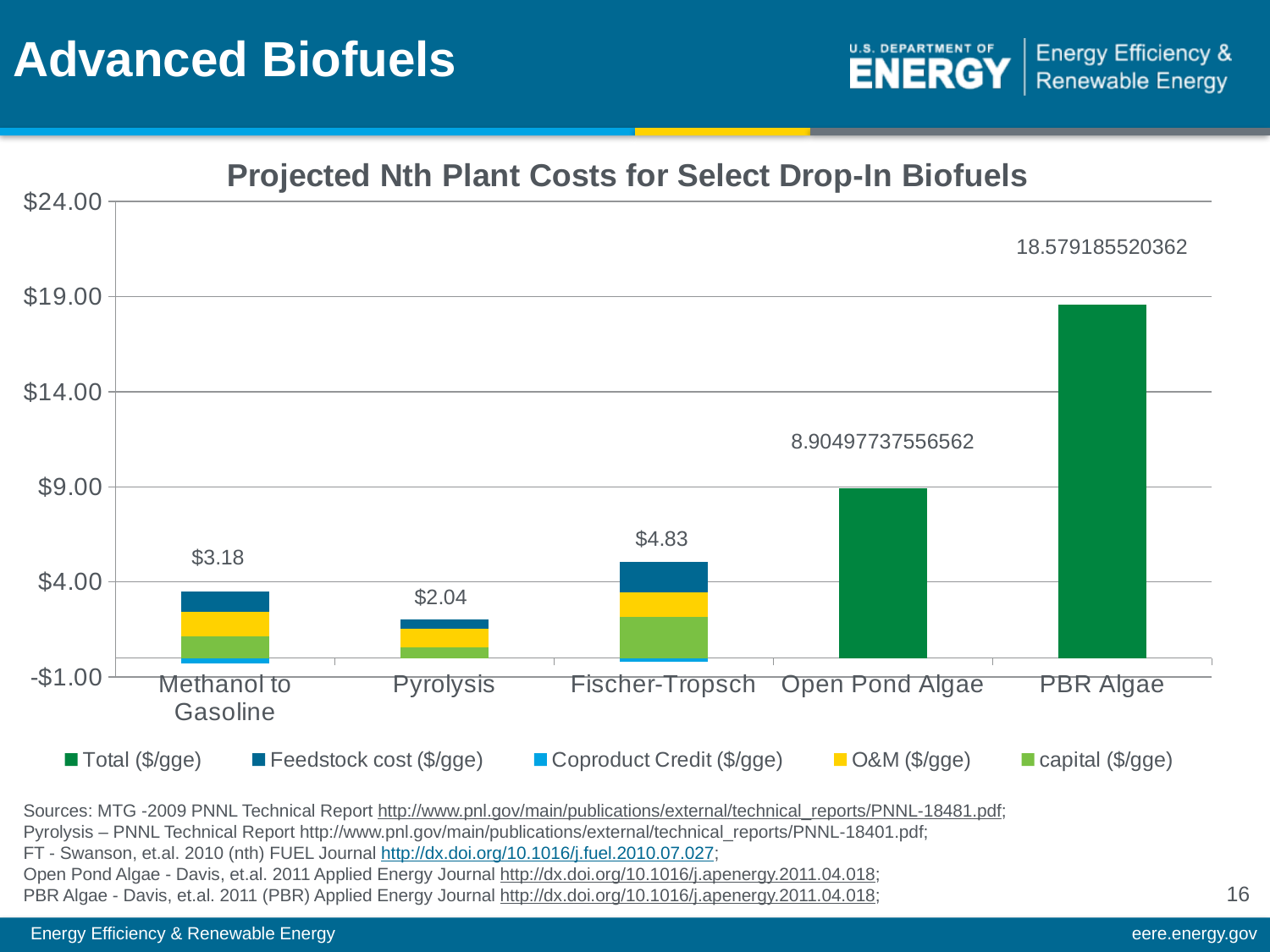
What is the projected cost label shown for Fischer-Tropsch? $4.83 Is the value for PBR Algae greater or less than $14.00? greater How many biofuel categories are shown on the x axis? 5 How many series does the legend list? 5 Which has a higher projected cost, Methanol to Gasoline or Pyrolysis? Methanol to Gasoline What is the projected cost label shown for Methanol to Gasoline? $3.18 Which biofuel has the lowest projected cost? Pyrolysis What is the difference between the labelled costs of Fischer-Tropsch and Methanol to Gasoline? $1.65 What is the projected cost label shown for Pyrolysis? $2.04 Which biofuel has the highest projected cost? PBR Algae What value is printed above the Open Pond Algae bar? 8.90497737556562 What value is printed above the PBR Algae bar? 18.579185520362